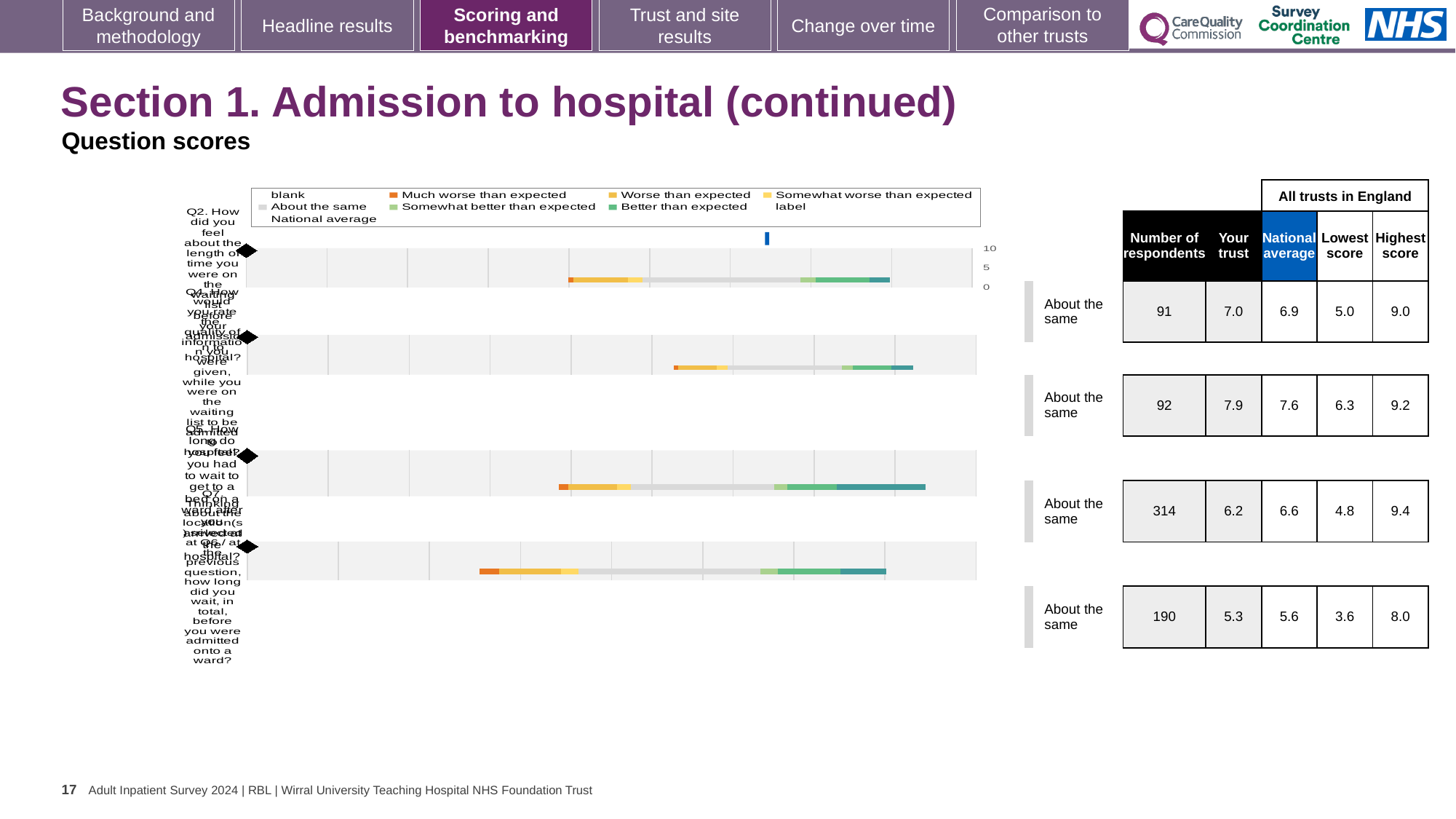
What is the lowest score across all trusts in England for Q4? 6.3 What is the 'Your trust' score for Q4? 7.9 Which question has the highest 'Your trust' score? Q4 For Q2, which is larger: the 'Your trust' score or the national average? Your trust What is the highest score across all trusts in England for Q7? 8.0 How many questions (bars) are plotted on the chart? 4 What benchmark category is shown next to each of the four questions? About the same What kind of chart is shown on the slide? bar chart Which question has the lowest 'Your trust' score? Q7 What is the difference between the national average and the 'Your trust' score for Q5? 0.4 How many respondents are listed for Q5? 314 Which question has the largest number of respondents? Q5